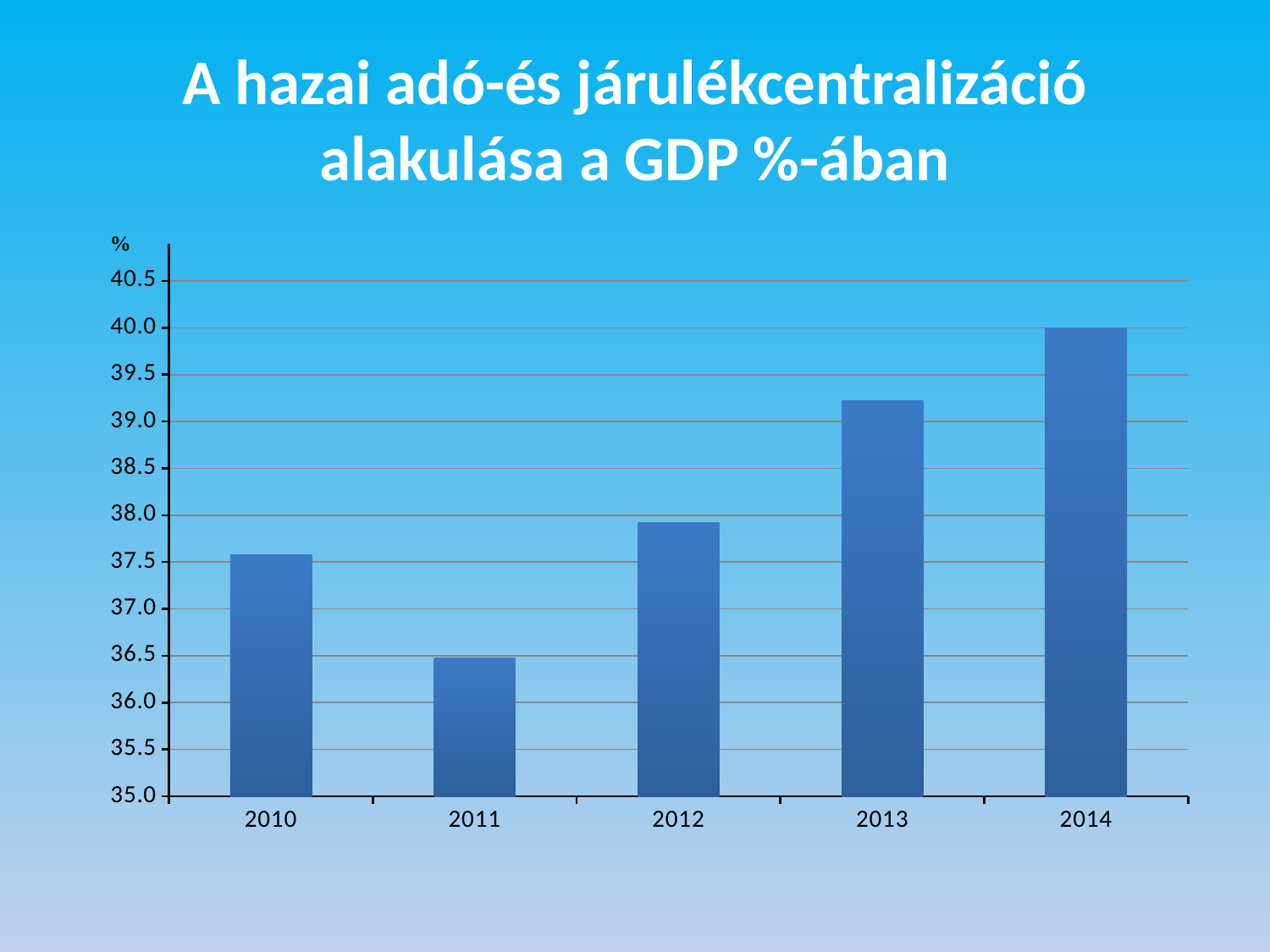
Is the value for 2012 greater or less than 37.5? greater What unit is shown at the top of the vertical axis? % Which is larger, the value for 2012 or the value for 2013? 2013 How many years are shown on the x axis of the chart? 5 Do the values rise or fall from 2011 to 2014? rise Is the value for 2011 greater or less than 37.0? less Is the value for 2013 greater or less than 39.5? less Which year has the lowest value in the chart? 2011 Which year has the highest value in the chart? 2014 What kind of chart is shown on the slide? bar chart